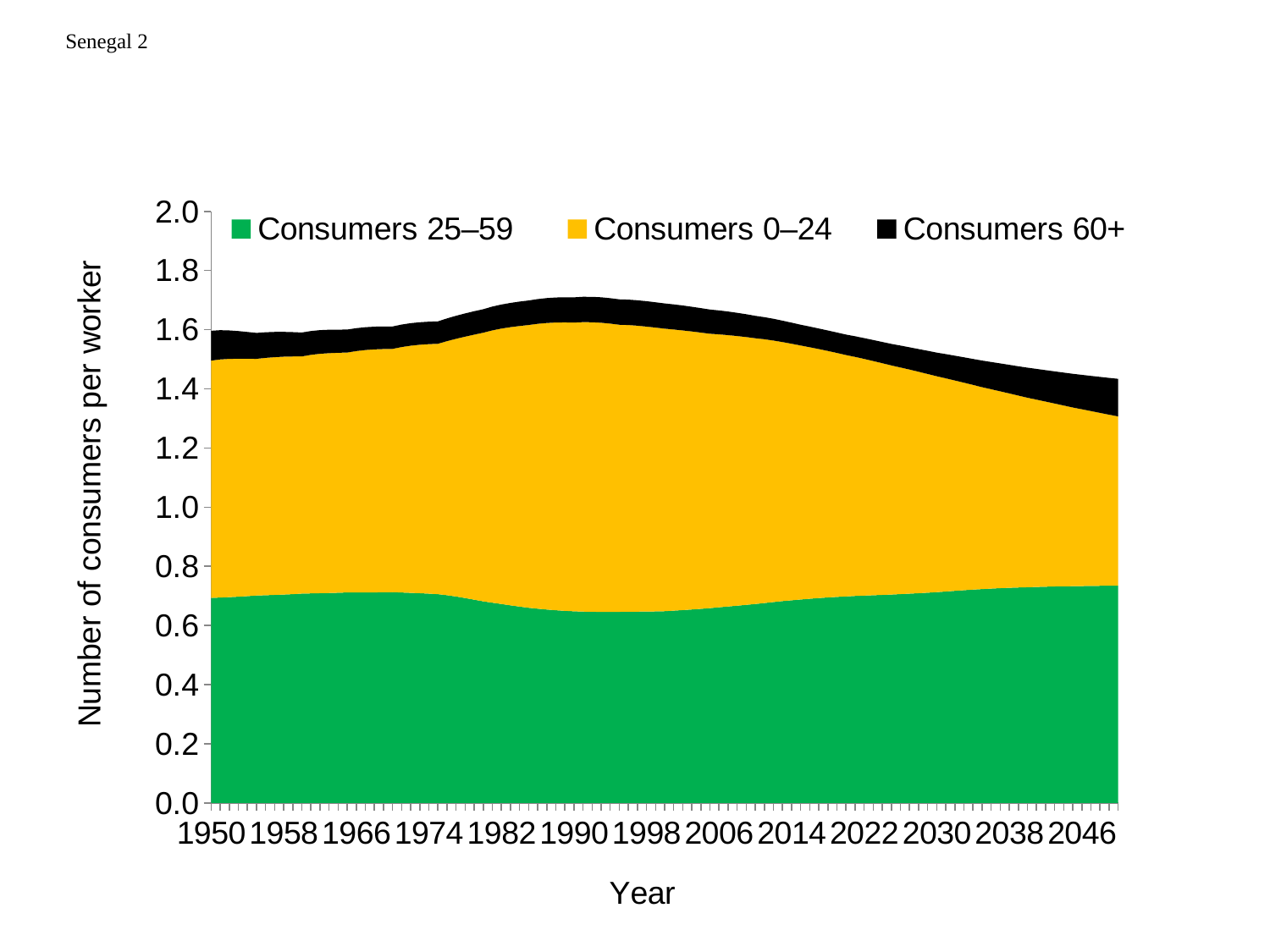
How many series does the legend list? 3 Which series contributes more to the total in 2046, Consumers 0–24 or Consumers 60+? Consumers 0–24 Does the total number of consumers per worker rise or fall between 1990 and 2046? fall What are the three series named in the legend? Consumers 25–59, Consumers 0–24, Consumers 60+ Is the total number of consumers per worker at its peak around 1990 greater or less than 1.8? less What kind of chart is shown on the slide? Stacked area chart How many year labels are shown on the x axis? 13 Is the total number of consumers per worker in 2046 greater or less than 1.6? less What is the label of the y axis? Number of consumers per worker Is the value for Consumers 25–59 in 1998 greater or less than 0.8? less